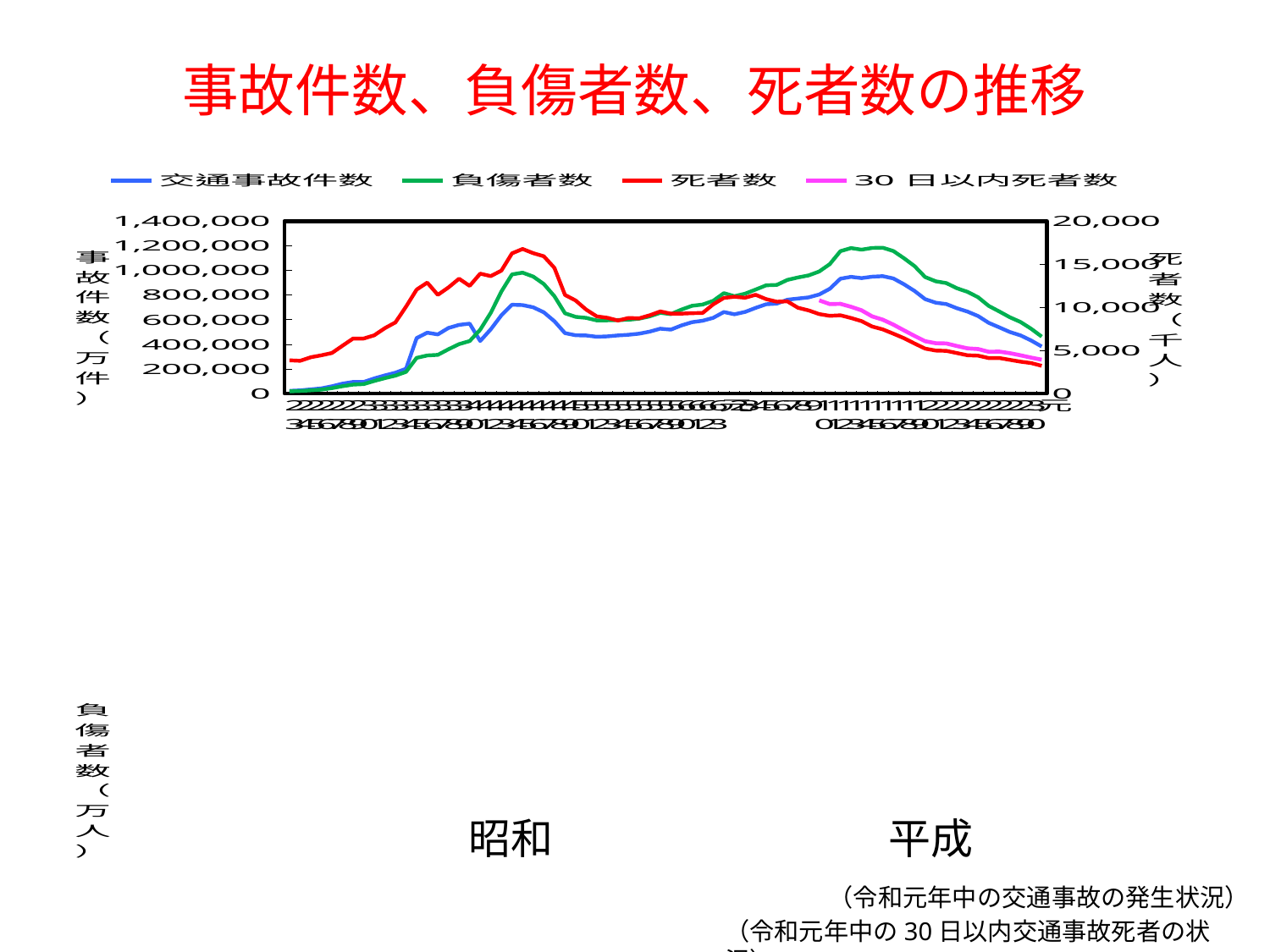
Which series has the highest peak on the left-axis scale: 交通事故件数 or 負傷者数? 負傷者数 Over the 平成 period on the right side of the chart, does the 死者数 line rise or fall? fall What is the highest tick value shown on the right vertical axis? 20,000 What is the highest tick value shown on the left vertical axis? 1,400,000 Is the peak value of the 交通事故件数 line greater or less than 1,000,000? less Is the peak value of the 負傷者数 line greater or less than 1,000,000? greater How many series does the legend list? 4 What is the title of the chart? 事故件数、負傷者数、死者数の推移 What kind of chart is shown on the slide? line chart Which series is drawn in red? 死者数 At the right end of the x axis, which line is higher on the left-axis scale: 負傷者数 or 交通事故件数? 負傷者数 Is the peak value of the 死者数 line greater or less than 15,000? greater